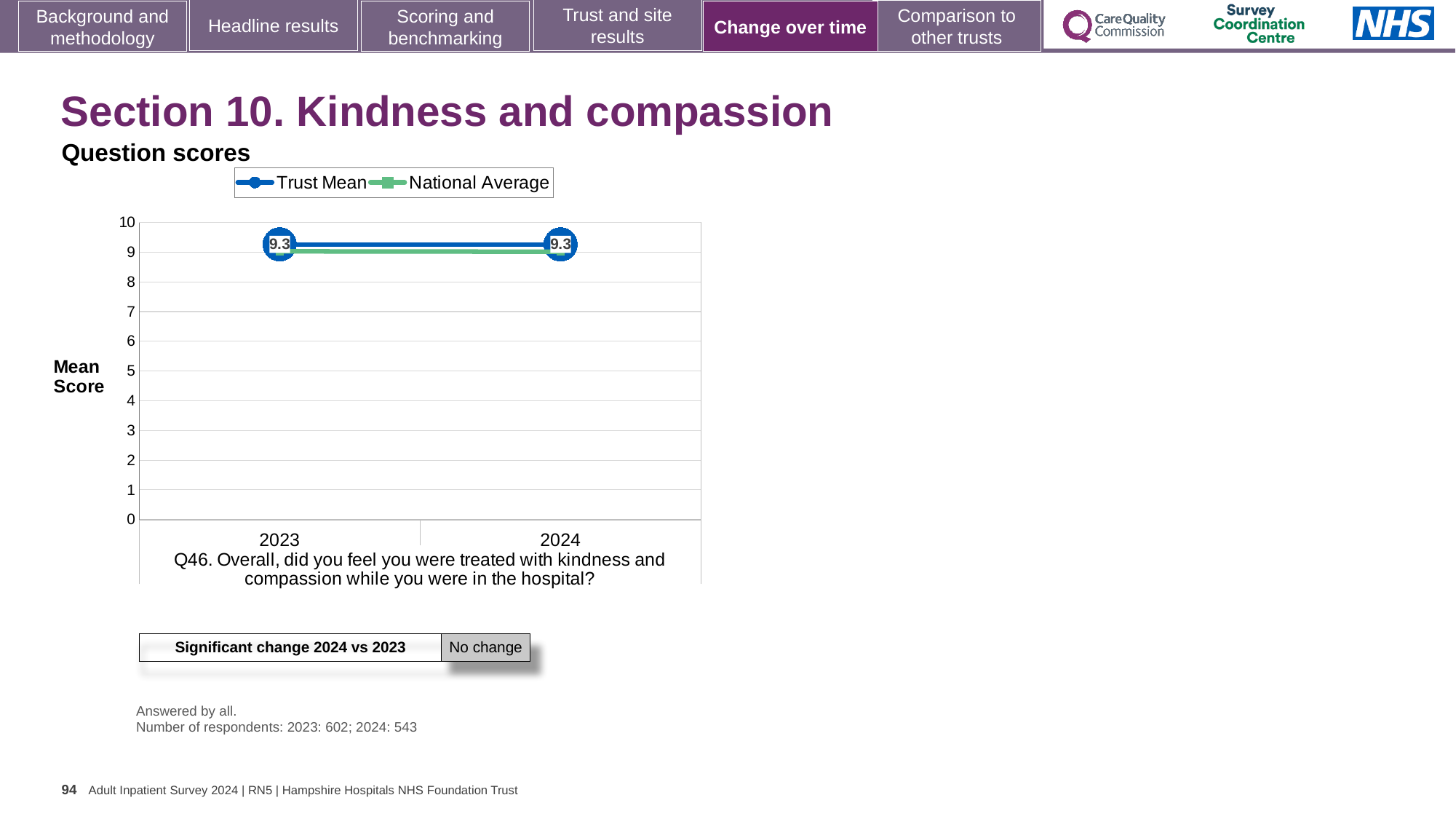
What is the Trust Mean score for 2023? 9.3 Does the Trust Mean rise, fall or stay the same from 2023 to 2024? Stays the same What is the label of the y axis? Mean Score What is the difference between the Trust Mean scores for 2024 and 2023? 0 What is the Trust Mean score for 2024? 9.3 In 2023, which is higher: the Trust Mean or the National Average? Trust Mean Which series is shown in green in the legend? National Average Is the National Average value for 2023 greater or less than 8? greater How many years are plotted on the x axis? 2 How many series does the legend list? 2 What kind of chart is shown on the slide? Line chart Is the National Average value for 2024 greater or less than 9.3? less